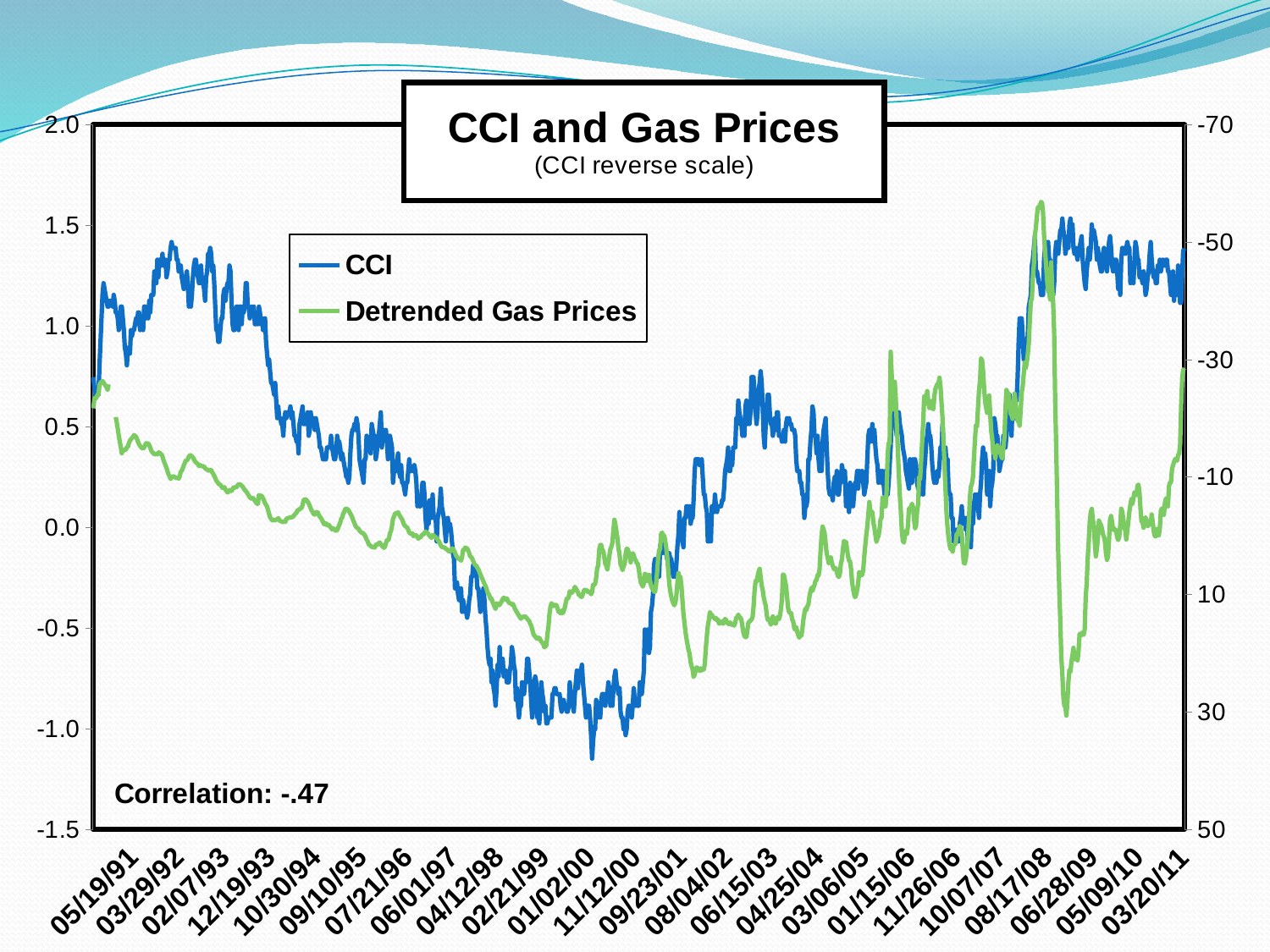
What are the two series named in the legend? CCI and Detrended Gas Prices At 03/29/92, which line is plotted higher on the chart, CCI or Detrended Gas Prices? CCI On the left axis scale, is the CCI line at 03/29/92 greater or less than 1.0? greater What kind of chart is shown on the slide? line chart At 06/28/09, which line is plotted higher on the chart, CCI or Detrended Gas Prices? CCI Does the CCI line rise or fall between 05/19/91 and 02/21/99? fall How many series does the legend list? 2 On the left axis scale, is the peak of the Detrended Gas Prices line near 08/17/08 greater or less than 1.0? greater How many date labels are shown along the x axis? 24 On the left axis scale, is the CCI line at 01/02/00 greater or less than -0.5? less What correlation value is printed on the chart? -.47 Does the CCI line rise or fall between 02/21/99 and 08/17/08? rise